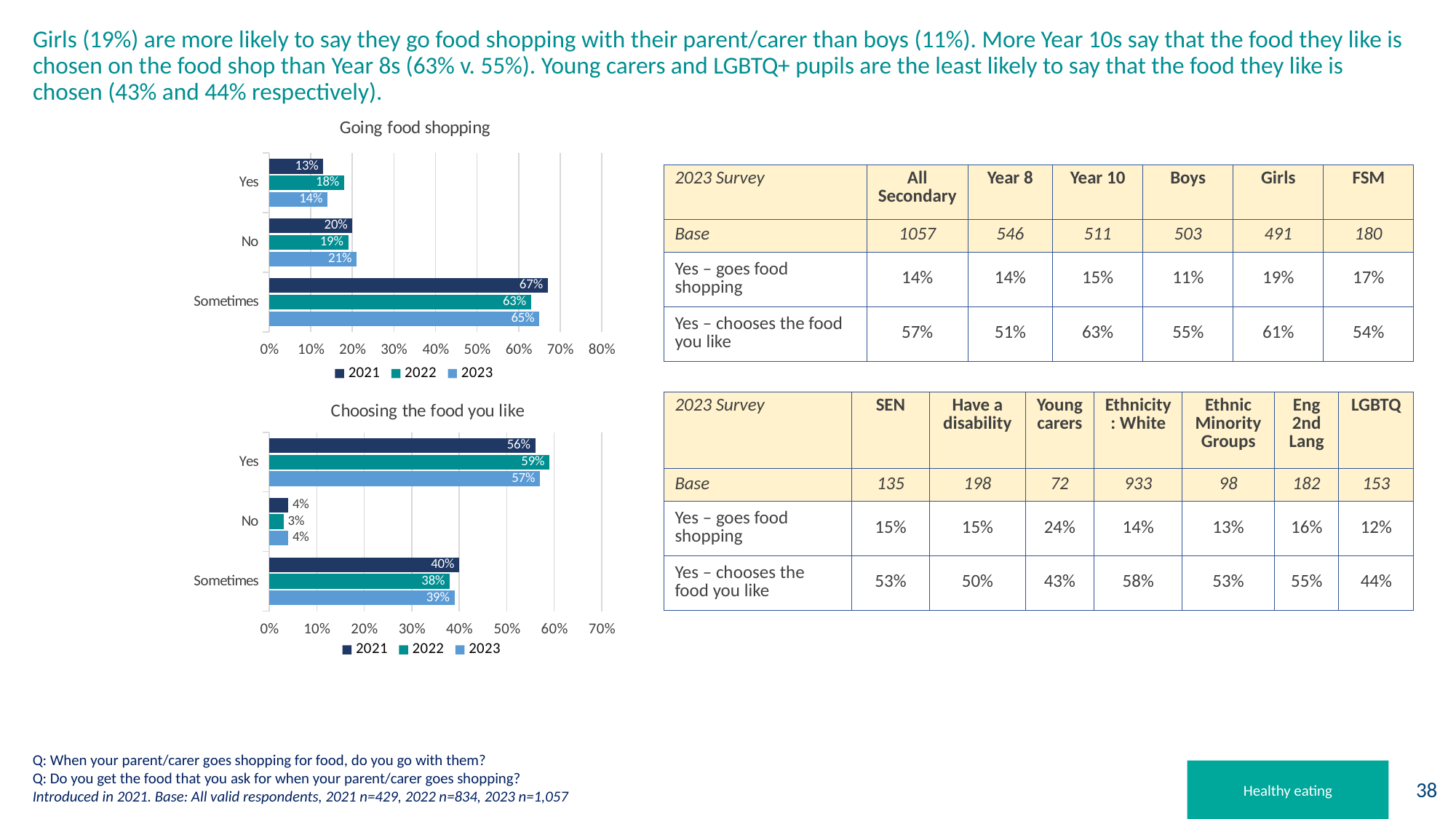
What kind of chart is the 'Going food shopping' chart? Bar chart In the 'Choosing the food you like' chart, which is larger for Yes: the 2021 value or the 2022 value? 2022 In the 'Going food shopping' chart, what is the difference between the 2021 and 2023 values for Sometimes? 2% In the 'Choosing the food you like' chart, which category has the lowest 2023 value? No In the 'Going food shopping' chart, what is the 2022 value for Sometimes? 63% In the 'Going food shopping' chart, what is the difference between the 2022 and 2021 values for Yes? 5% How many series does the legend of the 'Going food shopping' chart list? 3 How many categories are shown on the 'Choosing the food you like' chart? 3 In the 'Going food shopping' chart, what is the 2023 value for Yes? 14% In the 'Choosing the food you like' chart, what is the 2021 value for Sometimes? 40% In the 'Choosing the food you like' chart, what is the 2022 value for No? 3% In the 'Going food shopping' chart, which category has the highest 2021 value? Sometimes